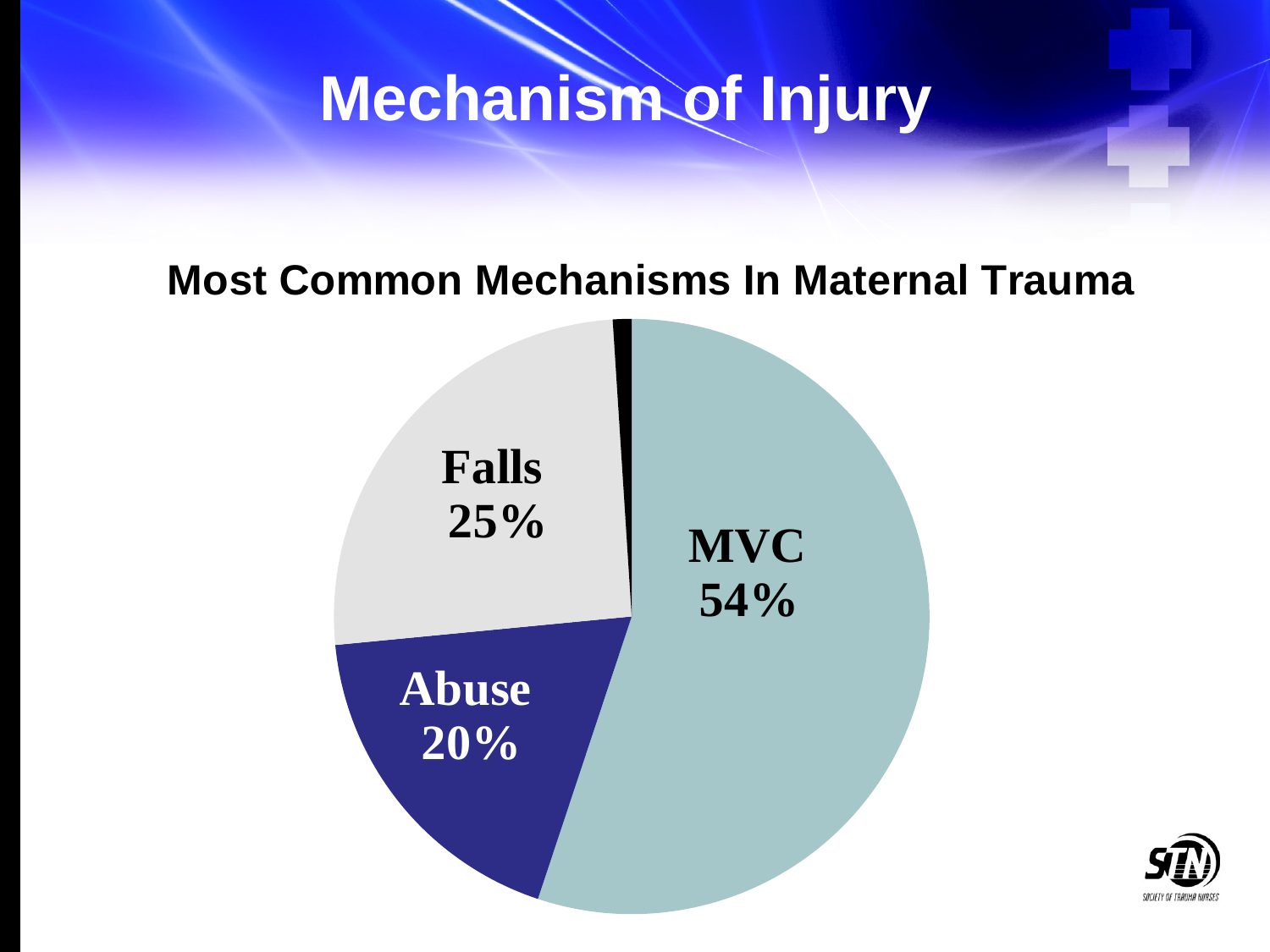
What percentage of the pie chart is Falls? 25% What percentage of the pie chart is MVC? 54% Of the labeled slices, which mechanism has the smallest share? Abuse Which slice is larger, Falls or Abuse? Falls How many percentage points larger is the MVC slice than the Falls slice? 29% What percentage of the pie chart is Abuse? 20% What is the difference between the Falls share and the Abuse share? 5% What is the difference between the MVC share and the Abuse share? 34% How many slices of the pie chart have a printed label? 3 Is the MVC share greater or less than 50%? greater What type of chart is shown on the slide? pie chart Which mechanism has the largest slice of the pie chart? MVC